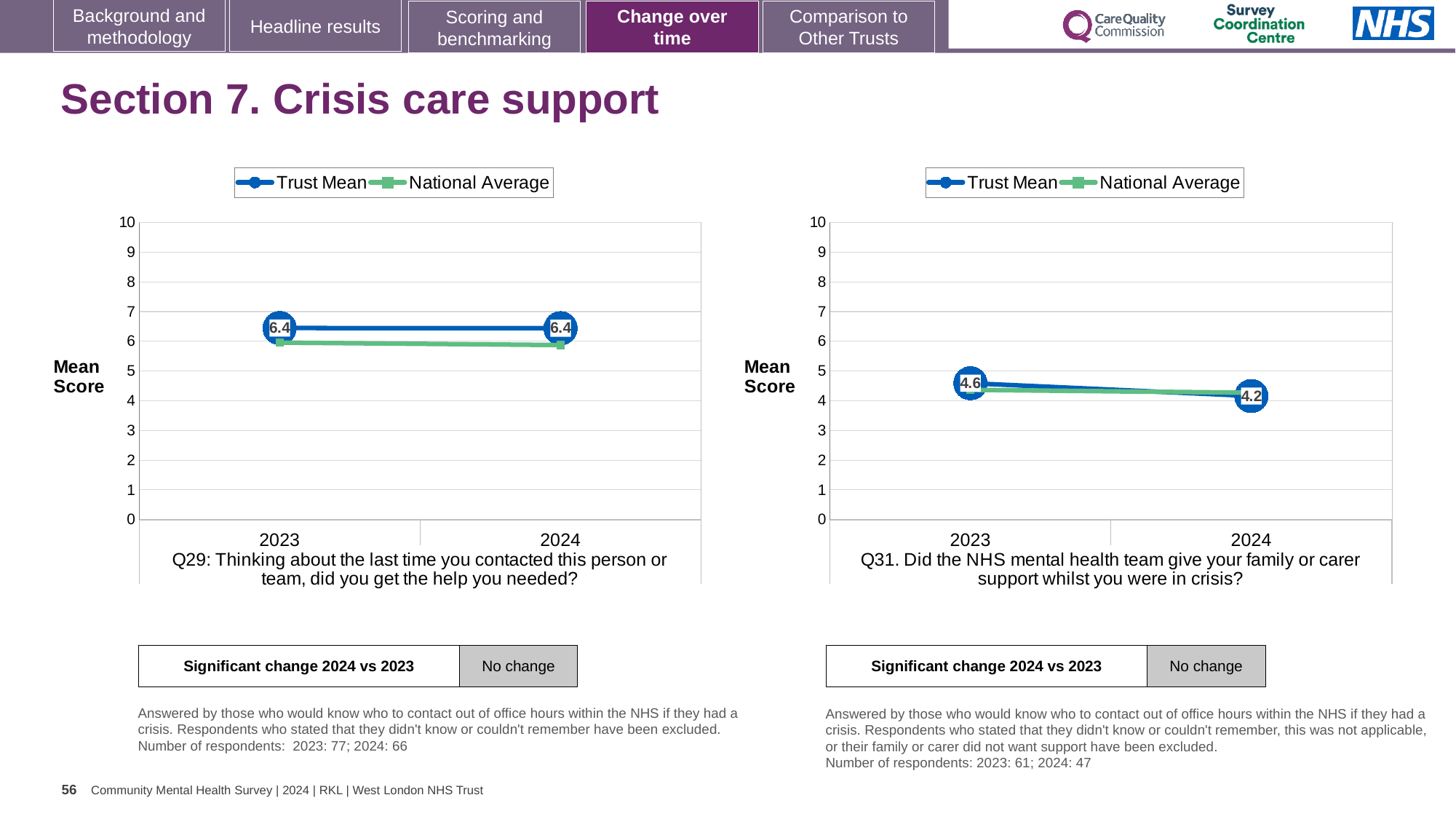
In the Q31 chart on the right, what is the Trust Mean value for 2024? 4.2 In the Q31 chart on the right, what is the Trust Mean value for 2023? 4.6 In the Q29 chart on the left, what is the Trust Mean value for 2024? 6.4 In the Q31 chart on the right, what is the difference between the Trust Mean in 2023 and in 2024? 0.4 How many series does the legend of the Q29 chart on the left list? 2 What kind of chart is the Q29 chart on the left? line chart In the Q29 chart on the left, what is the Trust Mean value for 2023? 6.4 How many years are plotted on the x axis of the Q31 chart on the right? 2 In the Q29 chart on the left, is the Trust Mean in 2024 higher, lower or the same as in 2023? the same In the Q31 chart on the right, does the Trust Mean rise or fall from 2023 to 2024? fall In the Q31 chart on the right, which series is shown in green? National Average In the Q29 chart on the left, is the National Average value for 2023 greater or less than 7? less